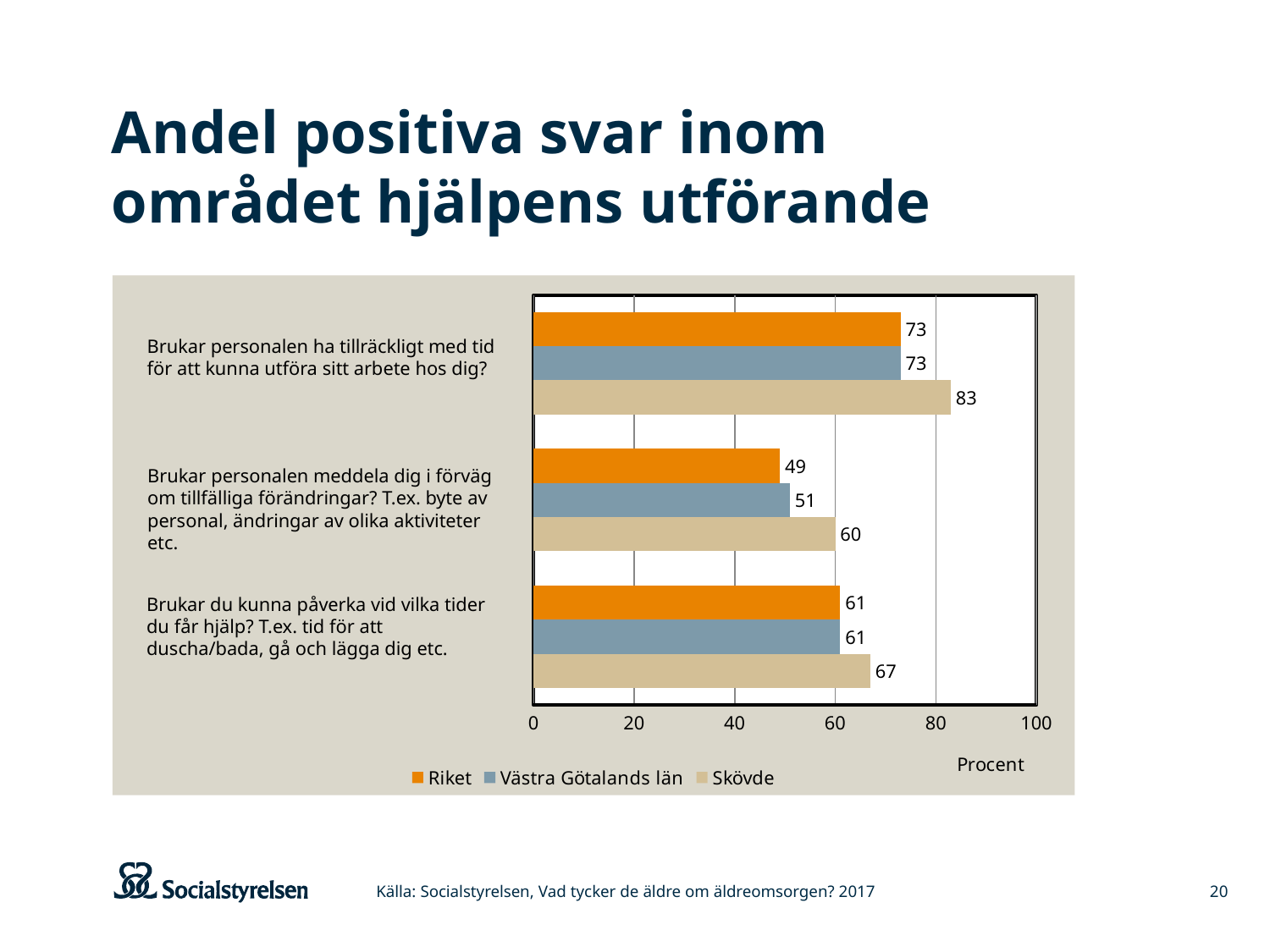
Which question has the highest value for Skövde? Brukar personalen ha tillräckligt med tid för att kunna utföra sitt arbete hos dig? On the question 'Brukar du kunna påverka vid vilka tider du får hjälp?', which is larger: the value for Skövde or the value for Riket? Skövde What is the value for Riket on the question 'Brukar personalen meddela dig i förväg om tillfälliga förändringar?' 49 How many questions (categories) are shown in the chart? 3 What is the value for Skövde on the question 'Brukar personalen ha tillräckligt med tid för att kunna utföra sitt arbete hos dig?' 83 What is the difference between the Skövde and Riket values on the question 'Brukar personalen meddela dig i förväg om tillfälliga förändringar?' 11 Is the value for Skövde on the question 'Brukar personalen ha tillräckligt med tid för att kunna utföra sitt arbete hos dig?' greater or less than 80? greater What is the value for Västra Götalands län on the question 'Brukar du kunna påverka vid vilka tider du får hjälp?' 61 What unit label is shown on the x axis of the chart? Procent How many series does the legend list? 3 Which question has the lowest value for Riket? Brukar personalen meddela dig i förväg om tillfälliga förändringar? What kind of chart is shown on the slide? bar chart